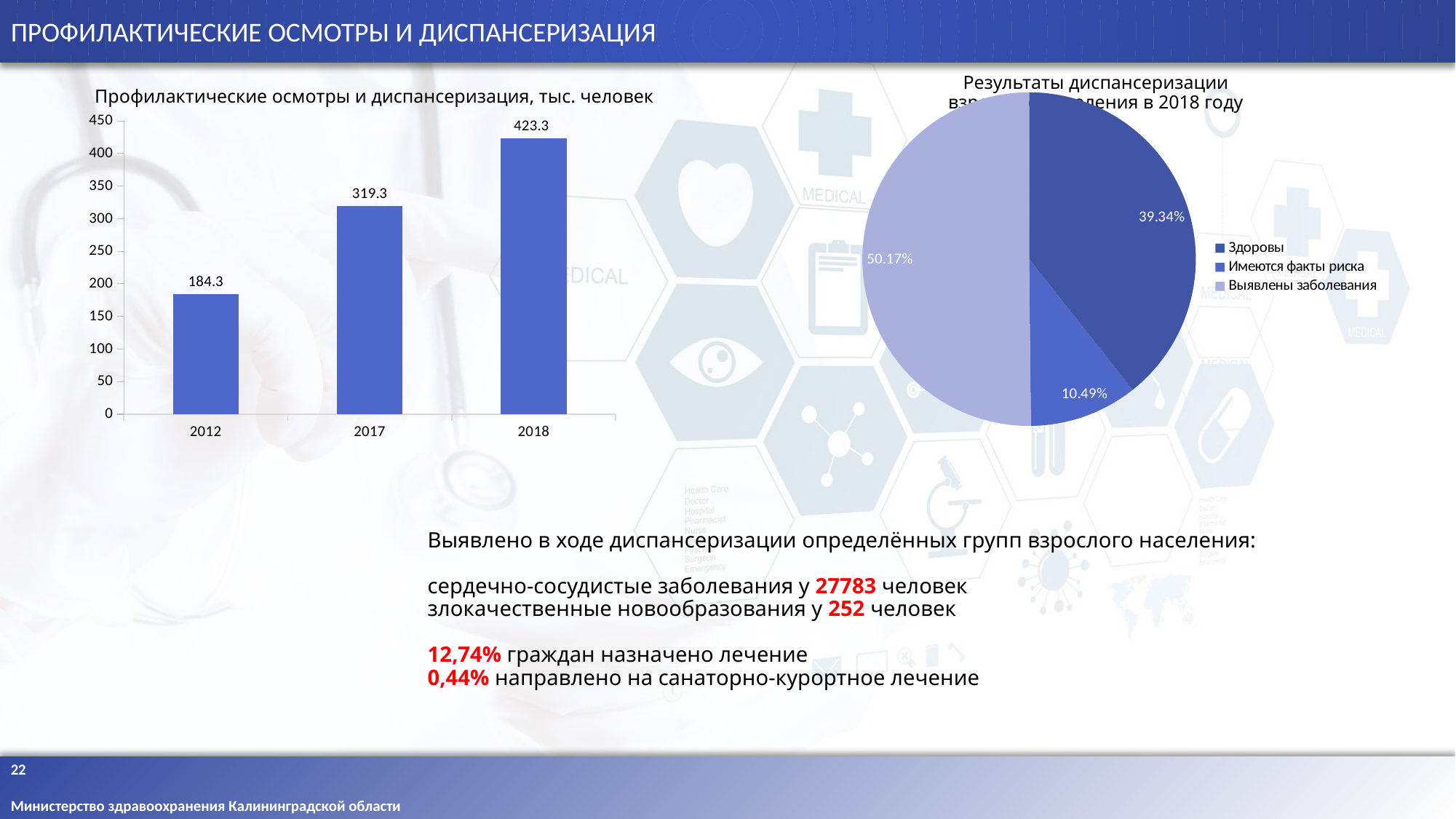
In the bar chart on the left, what is the difference between the values for 2018 and 2017? 104.0 How many entries does the legend of the pie chart on the right list? 3 In the bar chart on the left, do the values rise or fall from 2012 to 2018? rise In the pie chart on the right, which slice is larger: Здоровы or Имеются факты риска? Здоровы In the pie chart on the right, what share is labelled for Имеются факты риска? 10.49% In the pie chart on the right, what share is labelled for Выявлены заболевания? 50.17% What kind of chart is the chart on the left of the slide? bar chart How many bars are shown in the bar chart on the left? 3 In the bar chart on the left, which year has the highest value? 2018 In the bar chart on the left, what is the value for 2012? 184.3 In the bar chart on the left, which year has the lowest value? 2012 In the bar chart on the left, what is the value for 2018? 423.3